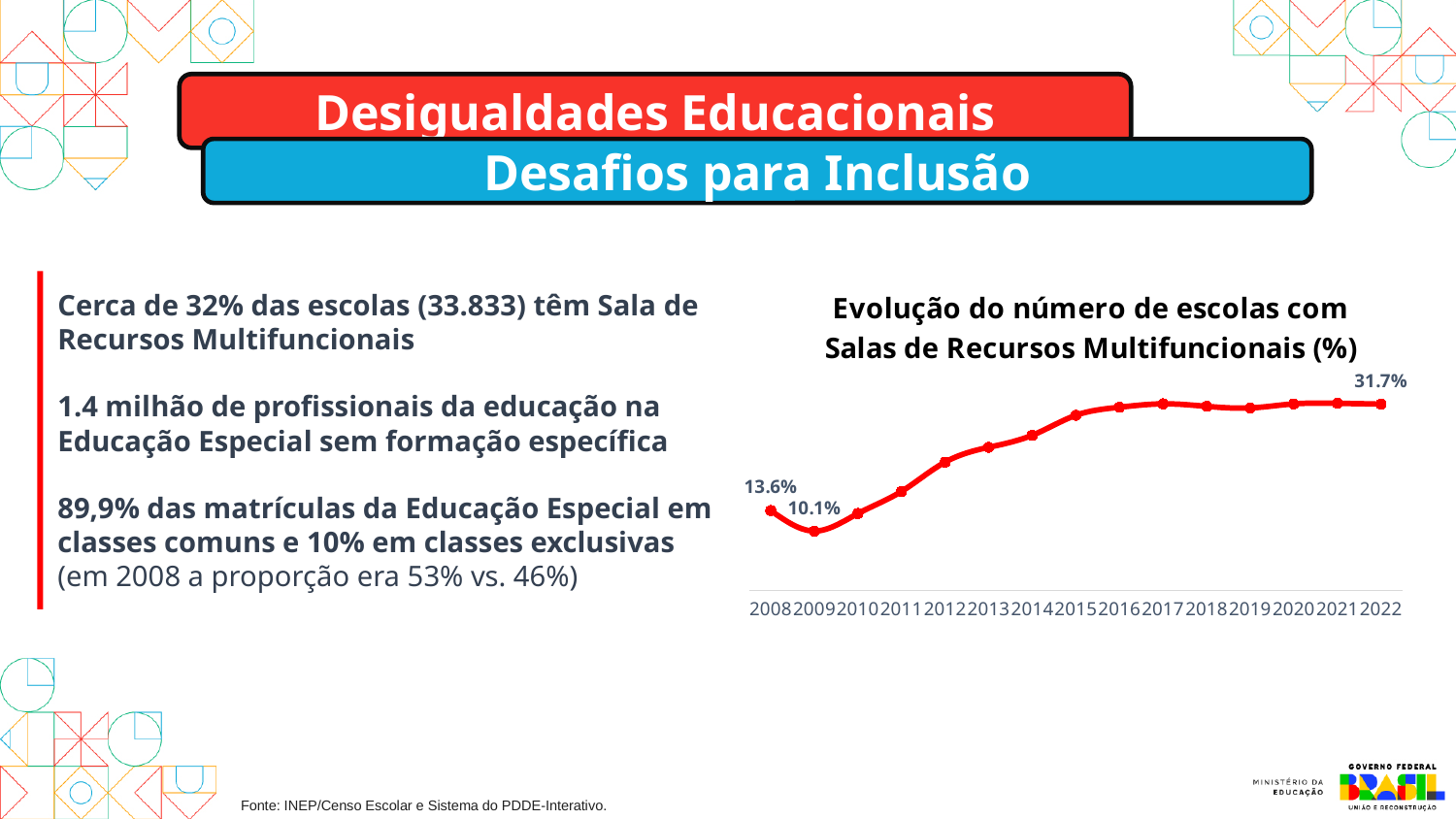
How many years are plotted on the x axis of the chart? 15 What type of chart is shown on the slide? line chart Which is larger, the value for 2022 or the value for 2008? 2022 What is the value for 2008 in the chart? 13.6% What is the difference between the value for 2022 and the value for 2008? 18.1 percentage points Which year has the lowest value in the chart? 2009 What is the title of the chart? Evolução do número de escolas com Salas de Recursos Multifuncionais (%) What is the difference between the value for 2022 and the value for 2009? 21.6 percentage points Which is larger, the value for 2008 or the value for 2009? 2008 Overall, do the values rise or fall from 2008 to 2022? rise What is the value for 2009 in the chart? 10.1% What is the value for 2022 in the chart? 31.7%